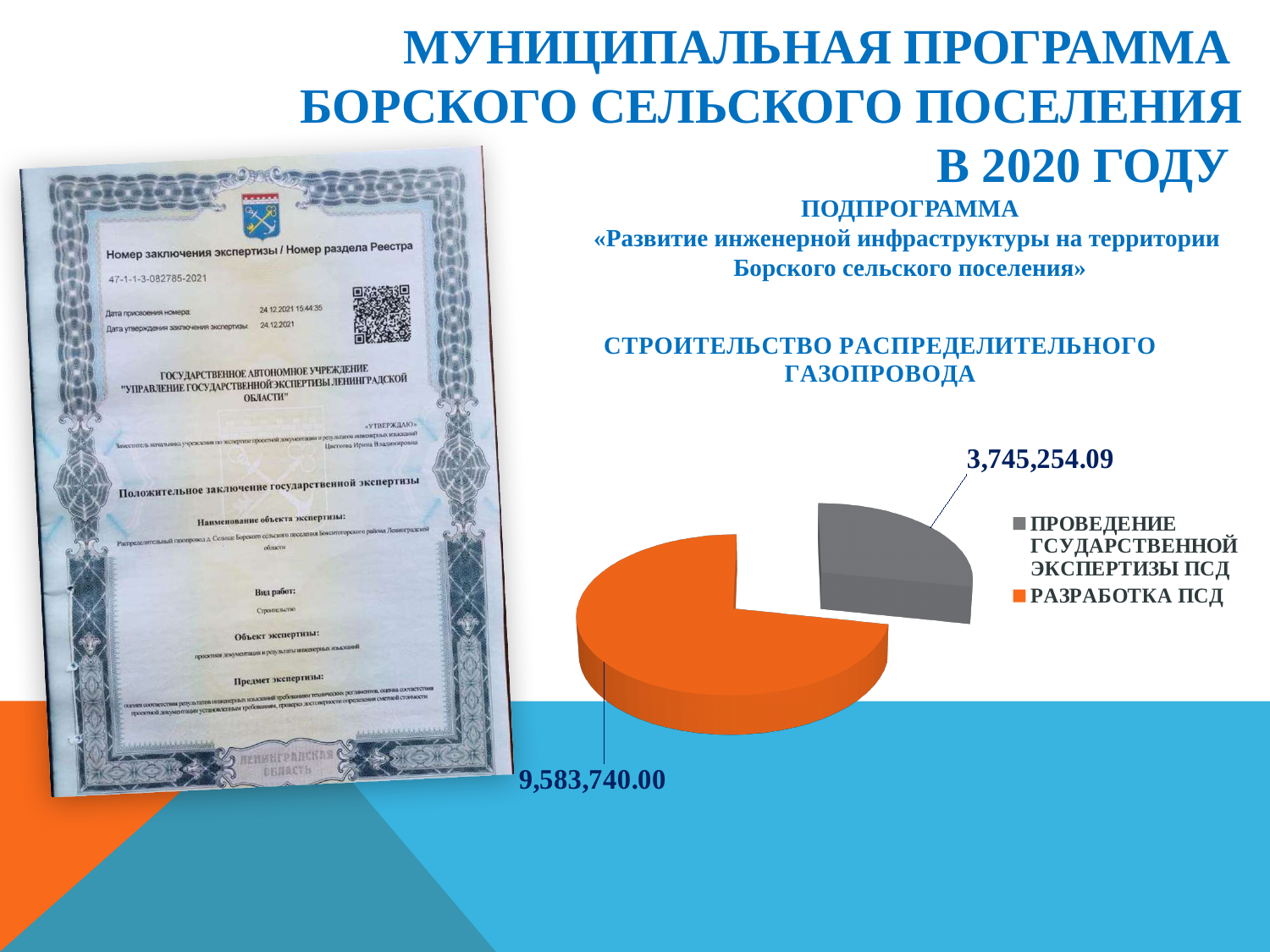
What colour is the РАЗРАБОТКА ПСД slice in the pie chart? Orange What is the difference between the values for РАЗРАБОТКА ПСД and ПРОВЕДЕНИЕ ГСУДАРСТВЕННОЙ ЭКСПЕРТИЗЫ ПСД in the pie chart? 5,838,485.91 What is the value for РАЗРАБОТКА ПСД in the pie chart? 9,583,740.00 What colour is the ПРОВЕДЕНИЕ ГСУДАРСТВЕННОЙ ЭКСПЕРТИЗЫ ПСД slice in the pie chart? Grey Which slice of the pie chart is the largest? РАЗРАБОТКА ПСД What kind of chart is shown on the slide? Pie chart What is the total of the two slices in the pie chart? 13,328,994.09 How many slices does the pie chart have? 2 How many entries does the legend of the pie chart list? 2 What is the value for ПРОВЕДЕНИЕ ГСУДАРСТВЕННОЙ ЭКСПЕРТИЗЫ ПСД in the pie chart? 3,745,254.09 Which slice of the pie chart is the smallest? ПРОВЕДЕНИЕ ГСУДАРСТВЕННОЙ ЭКСПЕРТИЗЫ ПСД Which is larger in the pie chart: РАЗРАБОТКА ПСД or ПРОВЕДЕНИЕ ГСУДАРСТВЕННОЙ ЭКСПЕРТИЗЫ ПСД? РАЗРАБОТКА ПСД